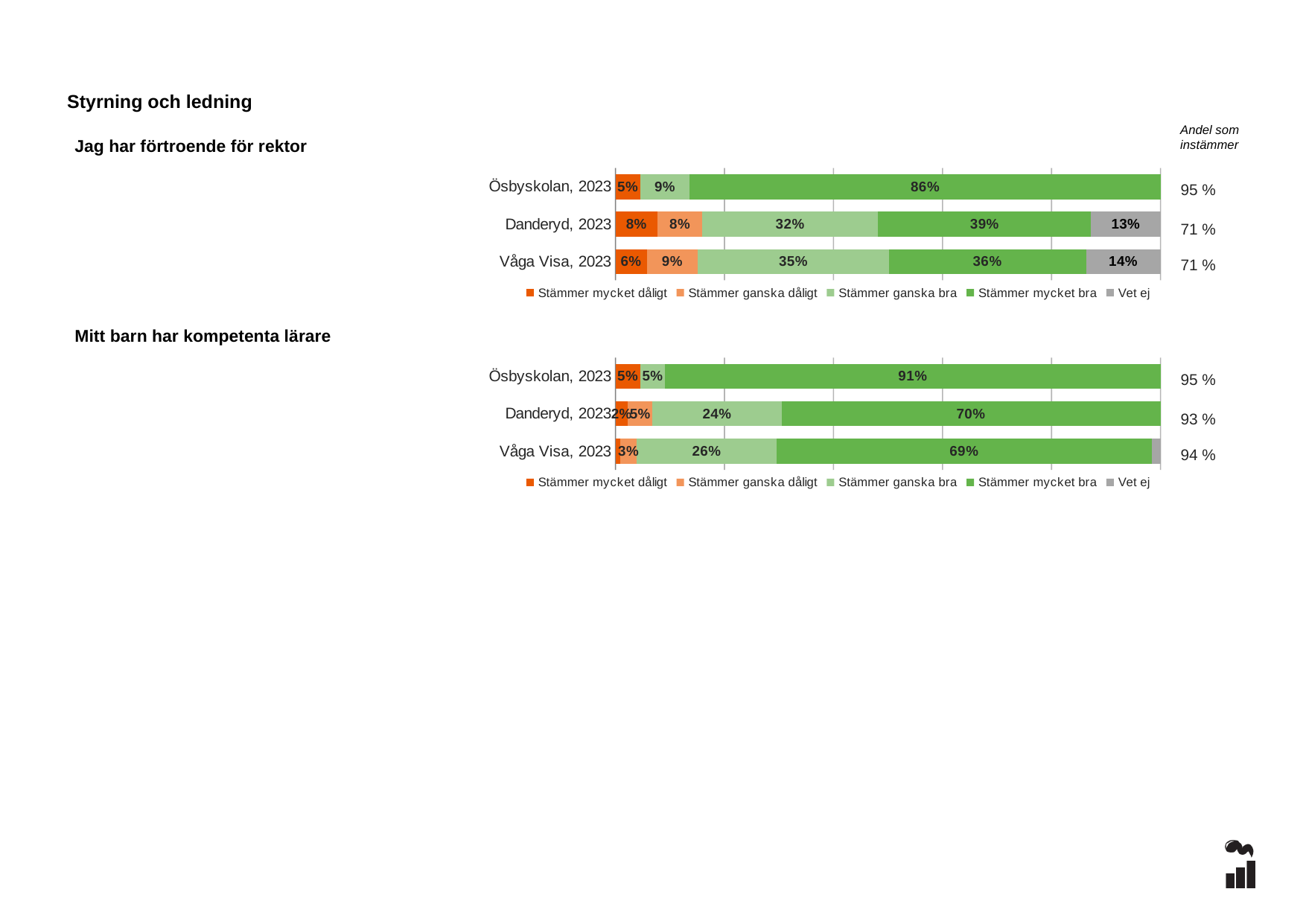
In the chart 'Jag har förtroende för rektor', which row has the highest 'Stämmer mycket bra' value? Ösbyskolan, 2023 How many rows (categories) are shown in the chart 'Jag har förtroende för rektor'? 3 In the chart 'Jag har förtroende för rektor', what is the value of 'Stämmer mycket bra' for Ösbyskolan, 2023? 86% In the chart 'Jag har förtroende för rektor', what is the 'Vet ej' value for Danderyd, 2023? 13% In the chart 'Jag har förtroende för rektor', what is the 'Andel som instämmer' shown for Danderyd, 2023? 71 % In the chart 'Mitt barn har kompetenta lärare', which has the larger 'Stämmer ganska bra' value, Danderyd, 2023 or Våga Visa, 2023? Våga Visa, 2023 In the chart 'Mitt barn har kompetenta lärare', what is the 'Stämmer ganska bra' value for Danderyd, 2023? 24% In the chart 'Jag har förtroende för rektor', what is the 'Stämmer ganska bra' value for Våga Visa, 2023? 35% What kind of chart is 'Mitt barn har kompetenta lärare'? Stacked bar chart In the chart 'Mitt barn har kompetenta lärare', what is the 'Stämmer mycket bra' value for Ösbyskolan, 2023? 91% In the chart 'Jag har förtroende för rektor', what is the difference between the 'Stämmer mycket bra' values for Danderyd, 2023 and Våga Visa, 2023? 3 percentage points How many series does the legend of the chart 'Mitt barn har kompetenta lärare' list? 5